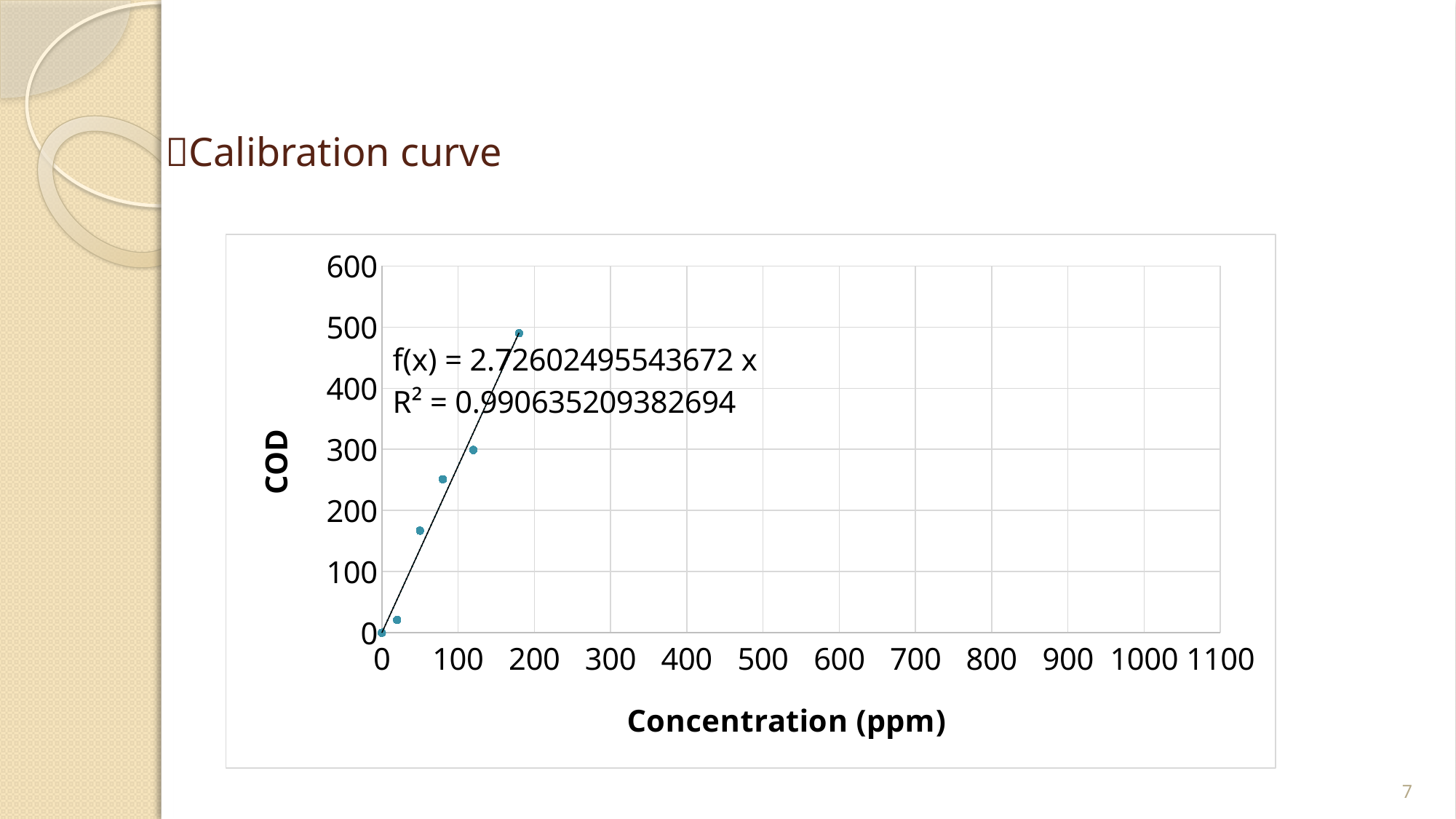
What is the highest tick value shown on the x axis? 1100 Do the COD values rise or fall as concentration increases along the x axis? rise Is the COD value of the point plotted at about 80 ppm greater or less than 300? less Is the COD value of the point plotted at about 50 ppm greater or less than 100? greater Is the COD value of the highest plotted point greater or less than 400? greater What is the highest tick value shown on the y axis? 600 What is the label of the x axis? Concentration (ppm) How many data points are plotted on the chart? 6 What is the label of the y axis? COD What kind of chart is shown on the slide? scatter chart